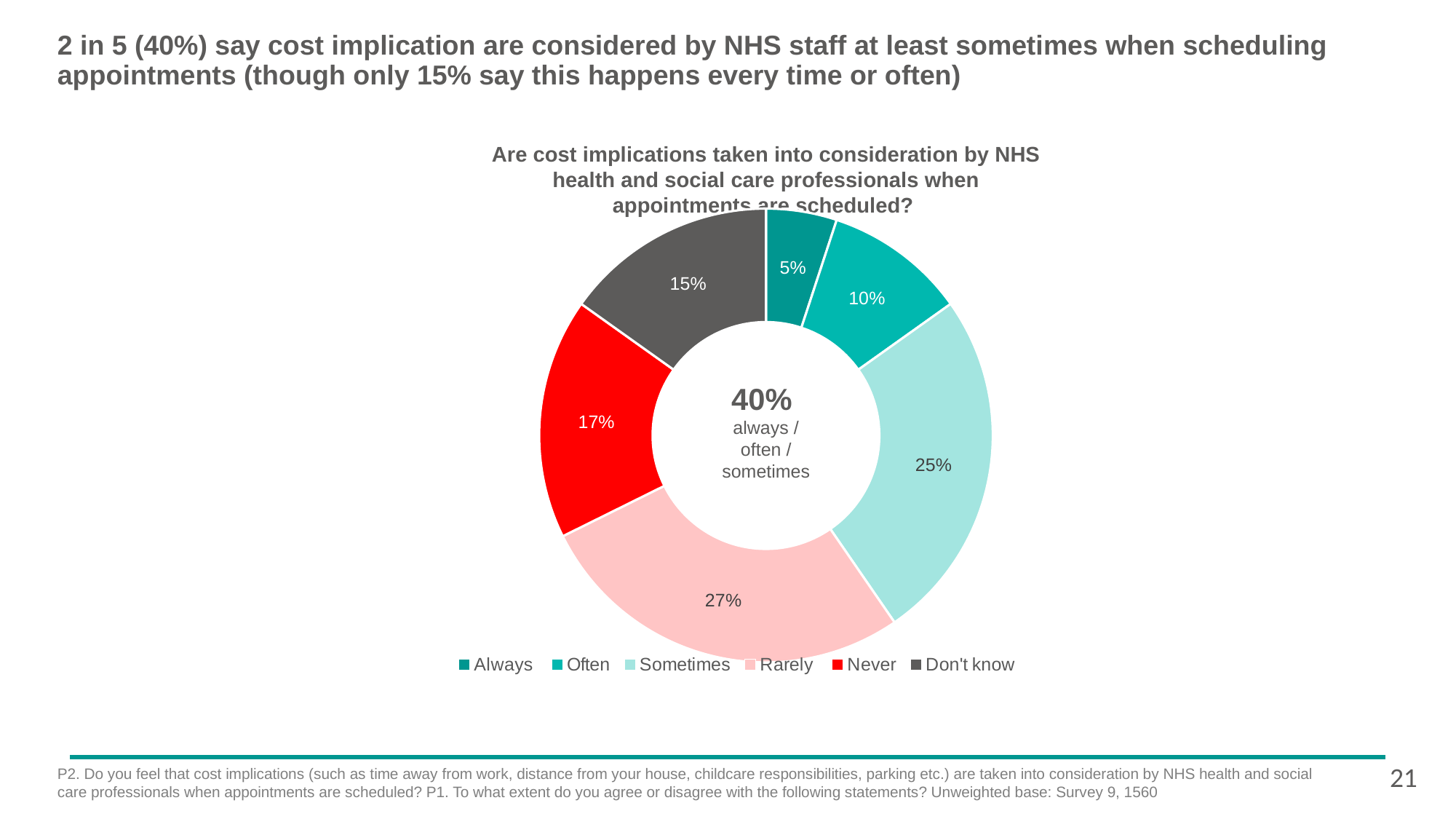
Which response category has the largest share of the chart? Rarely What percentage of respondents answered 'Don't know'? 15% What colour is the 'Never' segment of the chart? Red Which is larger, the share for 'Never' or the share for 'Don't know'? Never Which response category has the smallest share of the chart? Always What percentage of respondents answered 'Never'? 17% How many response categories does the legend list? 6 What kind of chart is shown on the slide? Pie chart (doughnut) What percentage of respondents answered 'Sometimes'? 25% What percentage of respondents answered 'Always'? 5% What combined percentage is shown in the centre of the chart for always / often / sometimes? 40% What is the difference in percentage points between 'Rarely' and 'Often'? 17